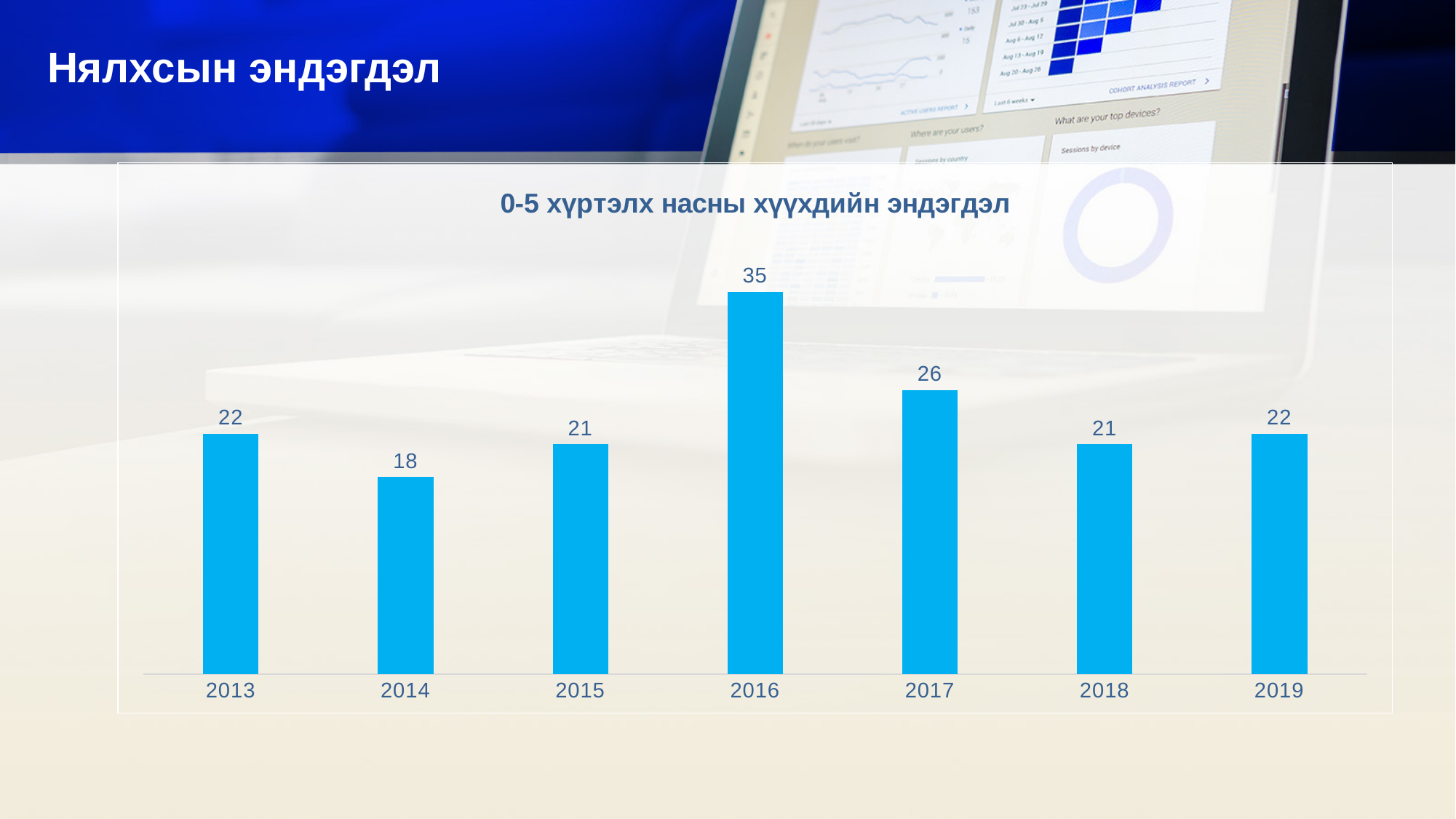
Which is larger, the value for 2017 or the value for 2018? 2017 What is the title of the chart? 0-5 хүртэлх насны хүүхдийн эндэгдэл What is the difference between the values for 2016 and 2017? 9 Which year has the highest value? 2016 What is the value for 2016? 35 What is the value for 2019? 22 What kind of chart is shown on the slide? bar chart What is the value for 2017? 26 What is the value for 2014? 18 How many years are shown on the x axis? 7 What is the difference between the values for 2013 and 2014? 4 Which year has the lowest value? 2014